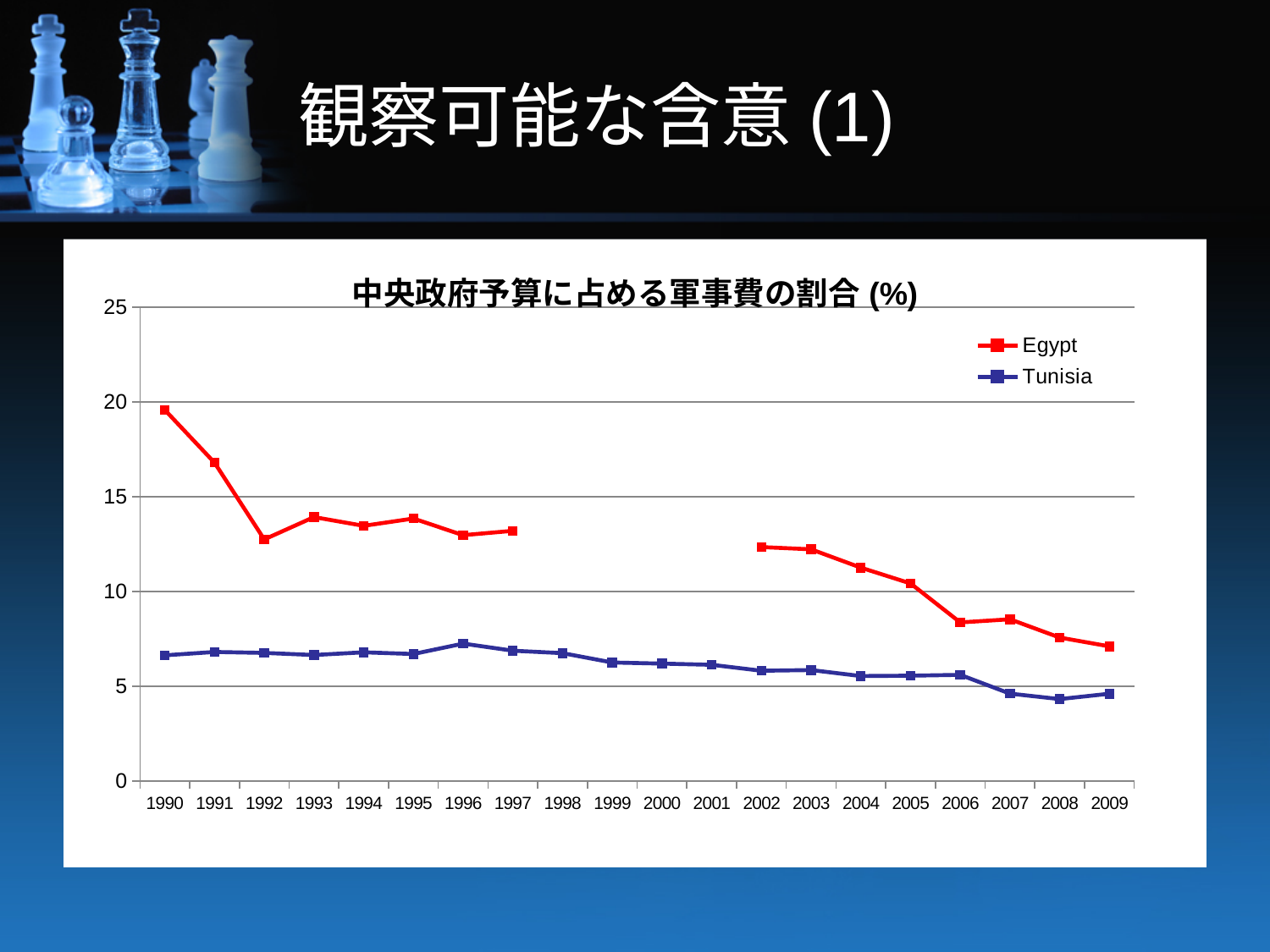
How many years are shown along the x axis? 20 How many series does the legend list? 2 Is the value for Tunisia in 2000 greater or less than 5? greater Which series has the larger value in 2005, Egypt or Tunisia? Egypt In which year is the value for Egypt highest? 1990 Does the value for Egypt generally rise or fall from 1990 to 2009? fall What kind of chart is shown on the slide? line chart What colour is the line for Egypt? red Is the value for Egypt in 1990 greater or less than 15? greater Is the value for Tunisia in 2008 greater or less than 5? less Which two series are shown in the legend? Egypt and Tunisia